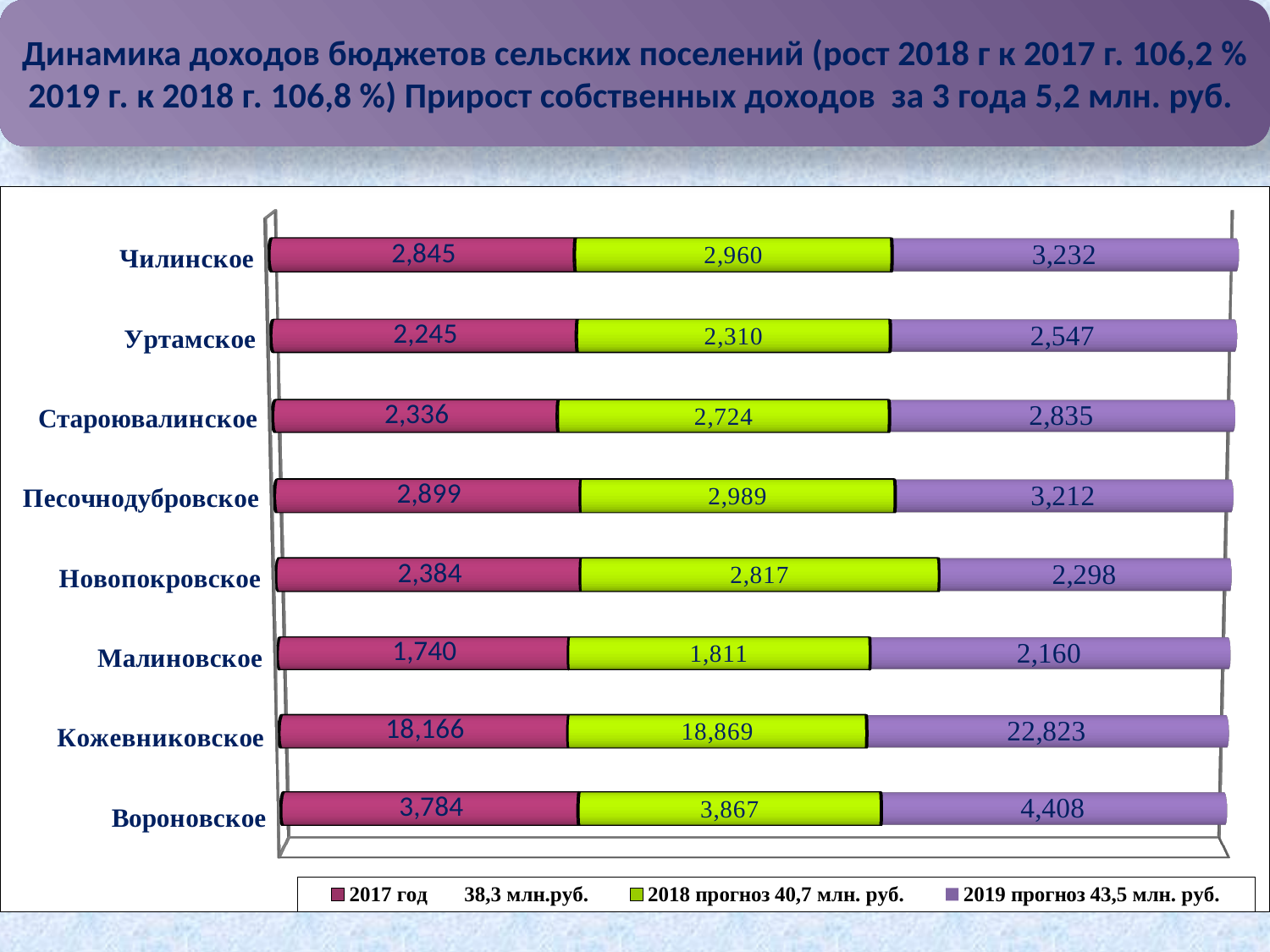
What total amount does the legend give for the 2019 прогноз series? 43,5 млн. руб. Which settlement has the highest 2017 год value? Кожевниковское What is the 2017 год value for Кожевниковское? 18,166 What is the 2019 прогноз value for Вороновское? 4,408 What is the difference between the 2019 прогноз and 2017 год values for Кожевниковское? 4,657 How many settlements are shown on the chart? 8 For Новопокровское, which is larger: the 2018 прогноз value or the 2019 прогноз value? 2018 прогноз How many series does the legend list? 3 Do the values for Чилинское rise or fall from 2017 to 2019? Rise Which settlement has the lowest 2019 прогноз value? Малиновское What kind of chart is shown on the slide? Stacked bar chart What is the 2018 прогноз value for Староювалинское? 2,724